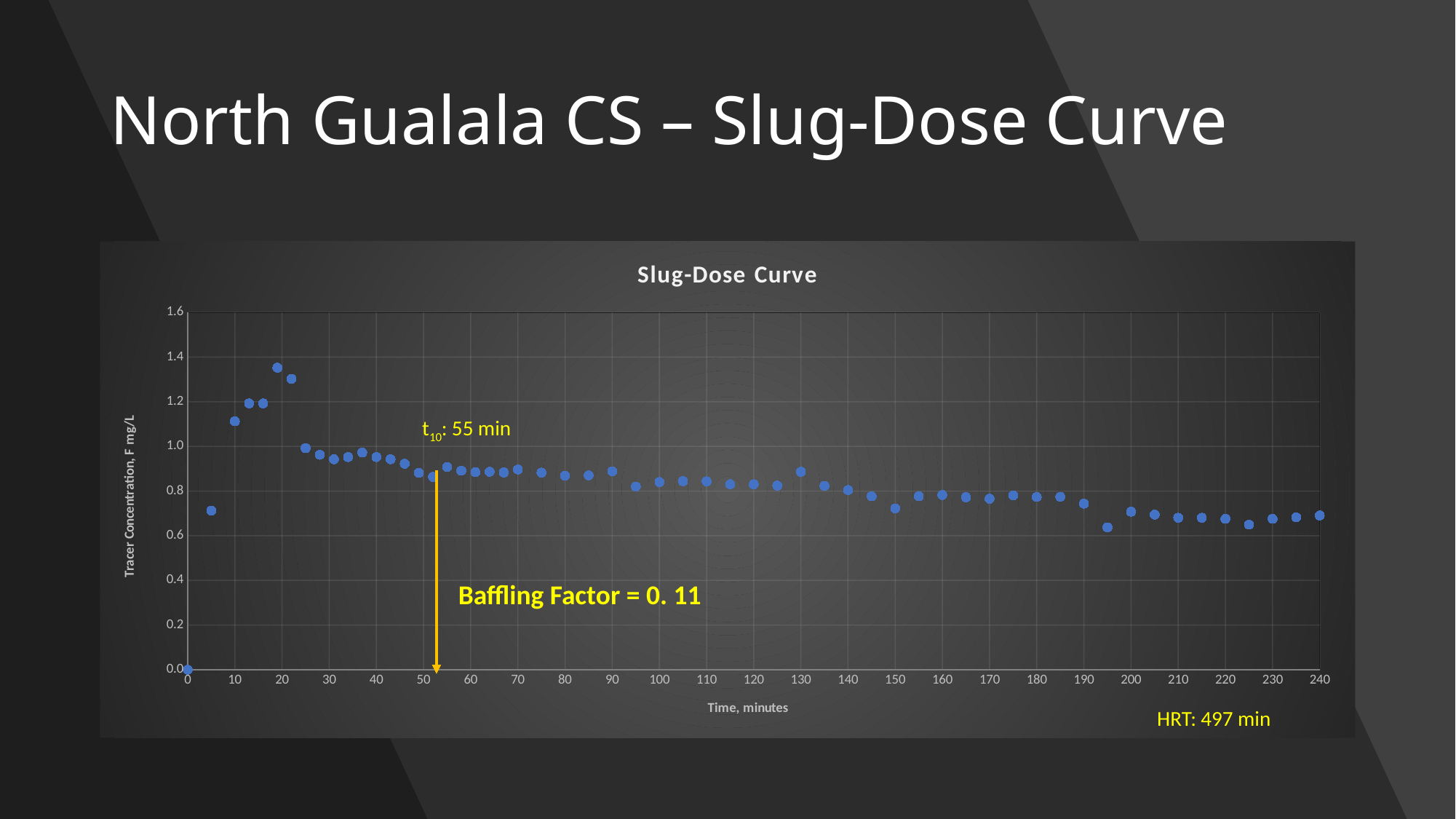
After the peak near 20 minutes, do the tracer concentration values generally rise or fall as time increases? fall Which is larger, the tracer concentration at 20 minutes or at 200 minutes? 20 minutes Is the tracer concentration at 240 minutes greater or less than 0.8? less Is the tracer concentration at 130 minutes greater or less than 0.8? greater Is the tracer concentration at 20 minutes greater or less than 1.2? greater What kind of chart is shown on the slide? scatter chart What t10 value is annotated on the chart? 55 min What baffling factor is stated on the chart? 0.11 What is the tracer concentration at time 0 minutes? 0.0